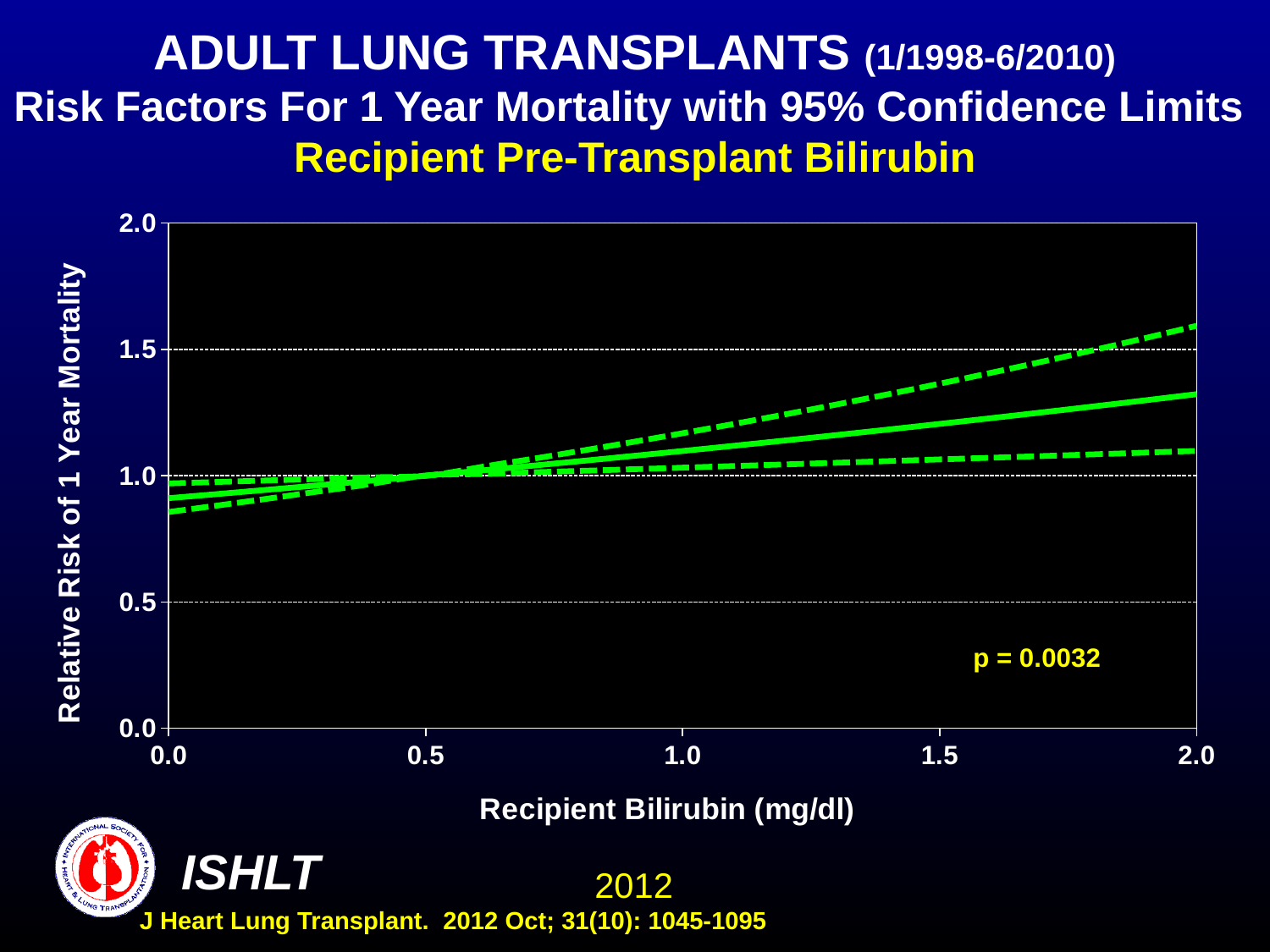
Is the upper 95% confidence limit (upper dashed line) at a recipient bilirubin of 2.0 mg/dl greater or less than 1.5? greater Is the relative risk of 1 year mortality (solid line) at a recipient bilirubin of 2.0 mg/dl greater or less than 1.5? less Is the relative risk of 1 year mortality (solid line) at a recipient bilirubin of 2.0 mg/dl greater or less than 1.0? greater What kind of chart is shown on the slide? line chart Does the relative risk of 1 year mortality rise or fall as recipient bilirubin increases from 0.0 to 2.0 mg/dl? rise What is the label of the y axis? Relative Risk of 1 Year Mortality What is the label of the x axis? Recipient Bilirubin (mg/dl) What p-value is shown on the chart? p = 0.0032 How many lines are plotted on the chart? 3